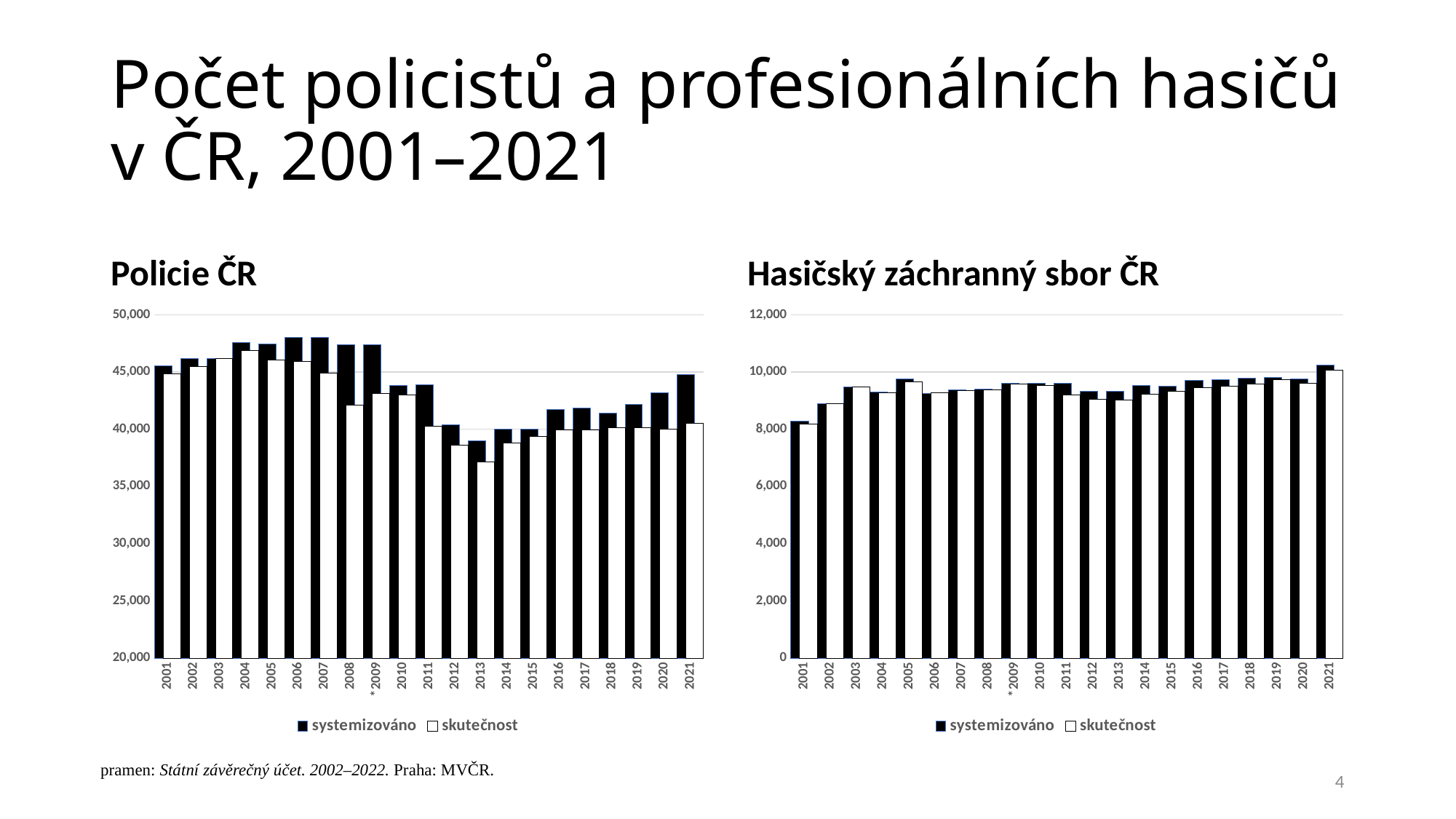
How many series does the legend of the "Hasičský záchranný sbor ČR" chart list? 2 In the "Policie ČR" chart, which is larger: the systemizováno value for 2004 or for 2013? 2004 In the "Policie ČR" chart, is the skutečnost value for 2013 greater or less than 40,000? less What are the two legend entries of the "Policie ČR" chart? systemizováno and skutečnost In the "Hasičský záchranný sbor ČR" chart, is the systemizováno value for 2001 greater or less than 10,000? less In the "Hasičský záchranný sbor ČR" chart, which year has the highest systemizováno value? 2021 In the "Hasičský záchranný sbor ČR" chart, is the skutečnost value for 2013 greater or less than 8,000? greater In the "Policie ČR" chart, do the skutečnost values rise or fall from 2007 to 2013? fall How many years are shown on the x axis of the "Policie ČR" chart? 21 What kind of chart is the "Policie ČR" chart? bar chart In the "Policie ČR" chart, which year has the lowest skutečnost value? 2013